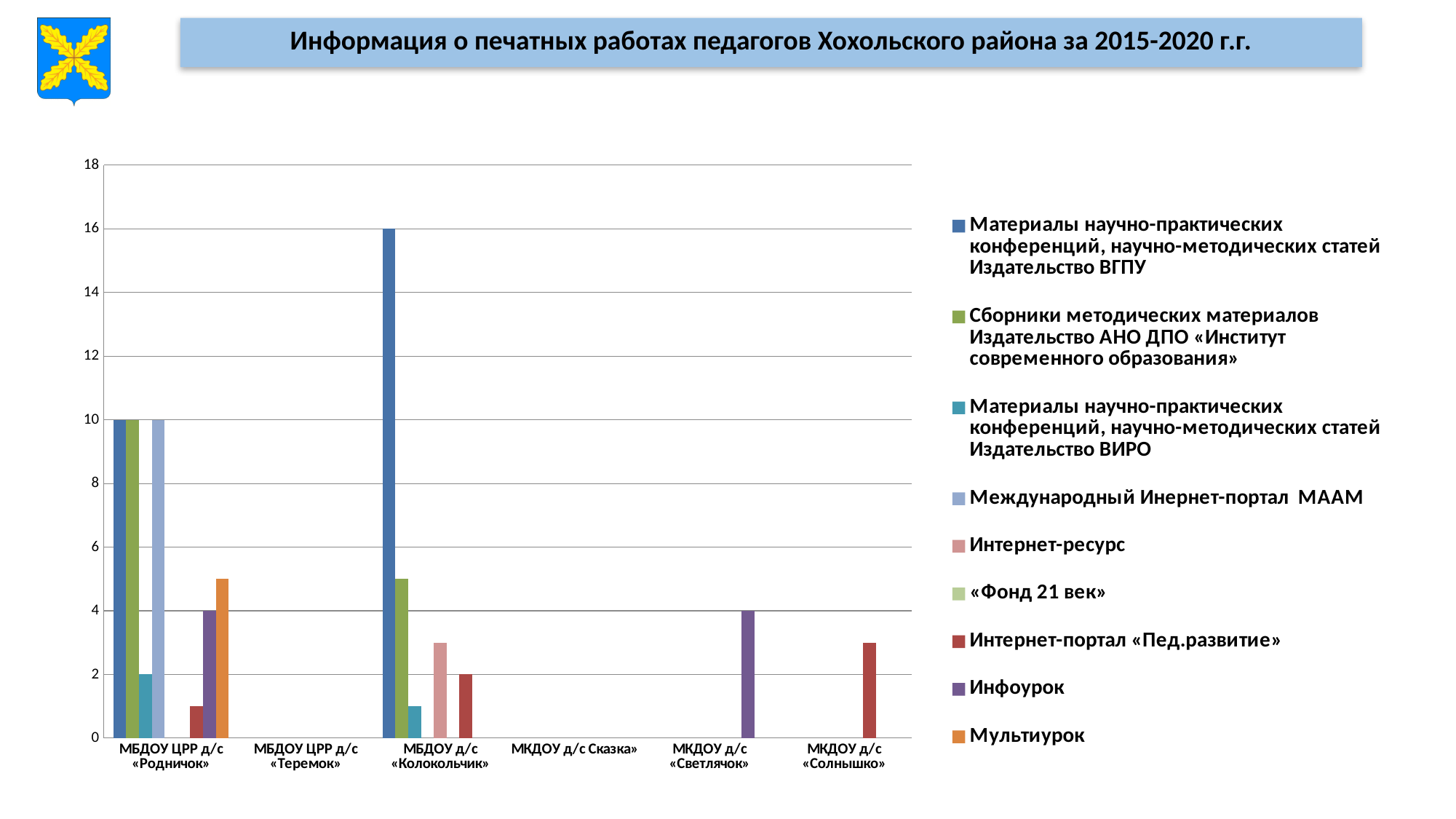
Is the value of «Мультиурок» for МБДОУ ЦРР д/с «Родничок» greater or less than 4? greater What is the value of «Инфоурок» for МКДОУ д/с «Светлячок»? 4 Is the value of «Интернет-ресурс» for МБДОУ д/с «Колокольчик» greater or less than 4? less What is the difference between the «Издательство ВГПУ» values for МБДОУ д/с «Колокольчик» and МБДОУ ЦРР д/с «Родничок»? 6 What kind of chart is shown on the slide? bar chart What is the value of «Материалы научно-практических конференций, научно-методических статей Издательство ВГПУ» for МБДОУ д/с «Колокольчик»? 16 How many series does the legend list? 9 How many categories are shown on the x axis? 6 Which category has the highest bar for «Издательство ВГПУ»? МБДОУ д/с «Колокольчик» Which series is shown in orange in the legend? Мультиурок What is the value of «Материалы научно-практических конференций, научно-методических статей Издательство ВИРО» for МБДОУ ЦРР д/с «Родничок»? 2 What is the value of «Материалы научно-практических конференций, научно-методических статей Издательство ВГПУ» for МБДОУ ЦРР д/с «Родничок»? 10